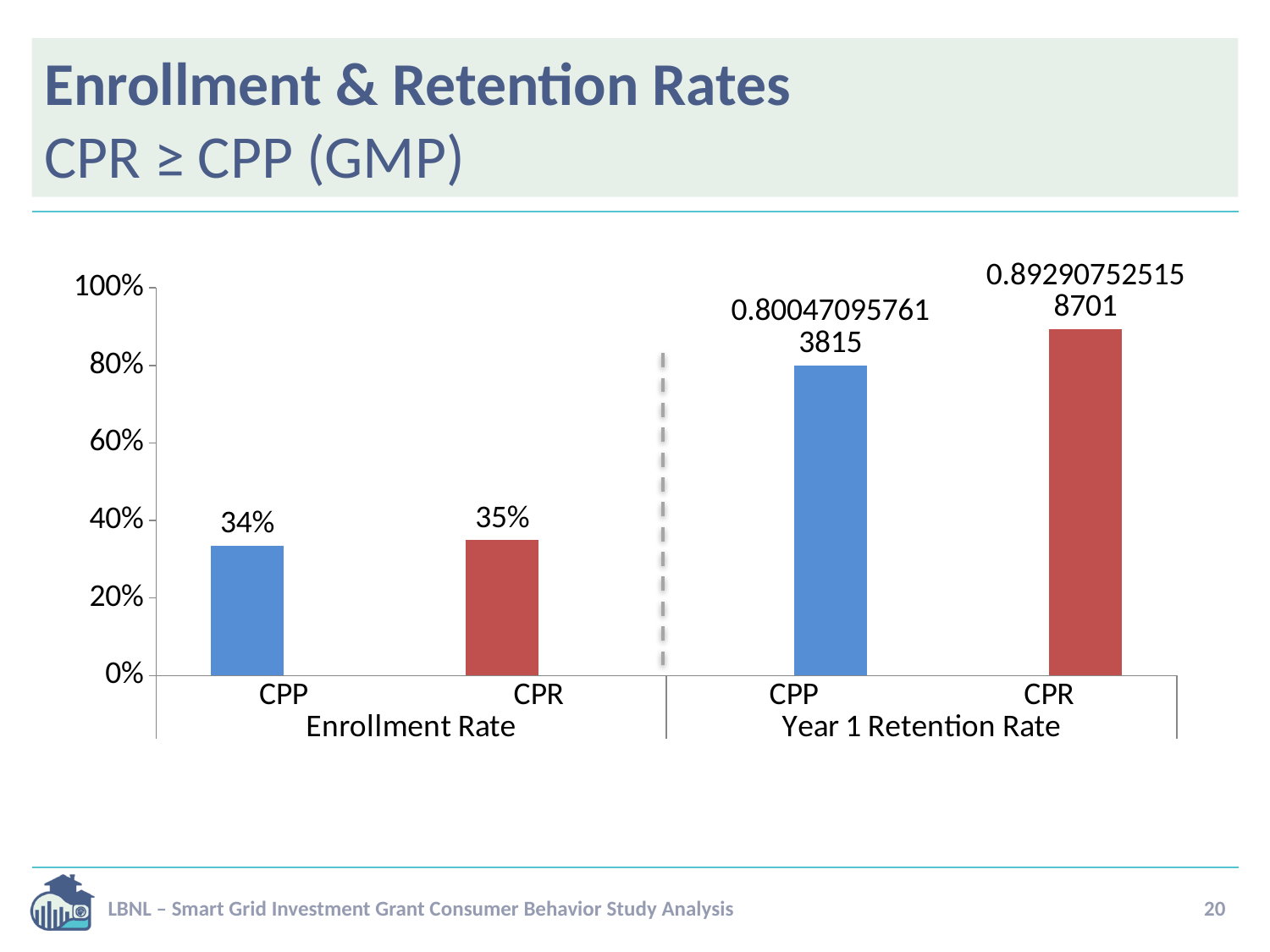
Is the Year 1 Retention Rate for CPP greater or less than 60%? greater Which has the higher Year 1 Retention Rate, CPP or CPR? CPR What is the Enrollment Rate for CPR? 35% What is the Year 1 Retention Rate value shown for CPP? 0.800470957613815 What is the difference between the CPR and CPP Enrollment Rates? 1% How many bars are plotted on the chart? 4 What is the Enrollment Rate for CPP? 34% Which bar has the lowest value on the chart? CPP Enrollment Rate What colour are the CPR bars on the chart? Red Which bar has the highest value on the chart? CPR Year 1 Retention Rate What is the Year 1 Retention Rate value shown for CPR? 0.892907525158701 What type of chart is shown on the slide? Bar chart